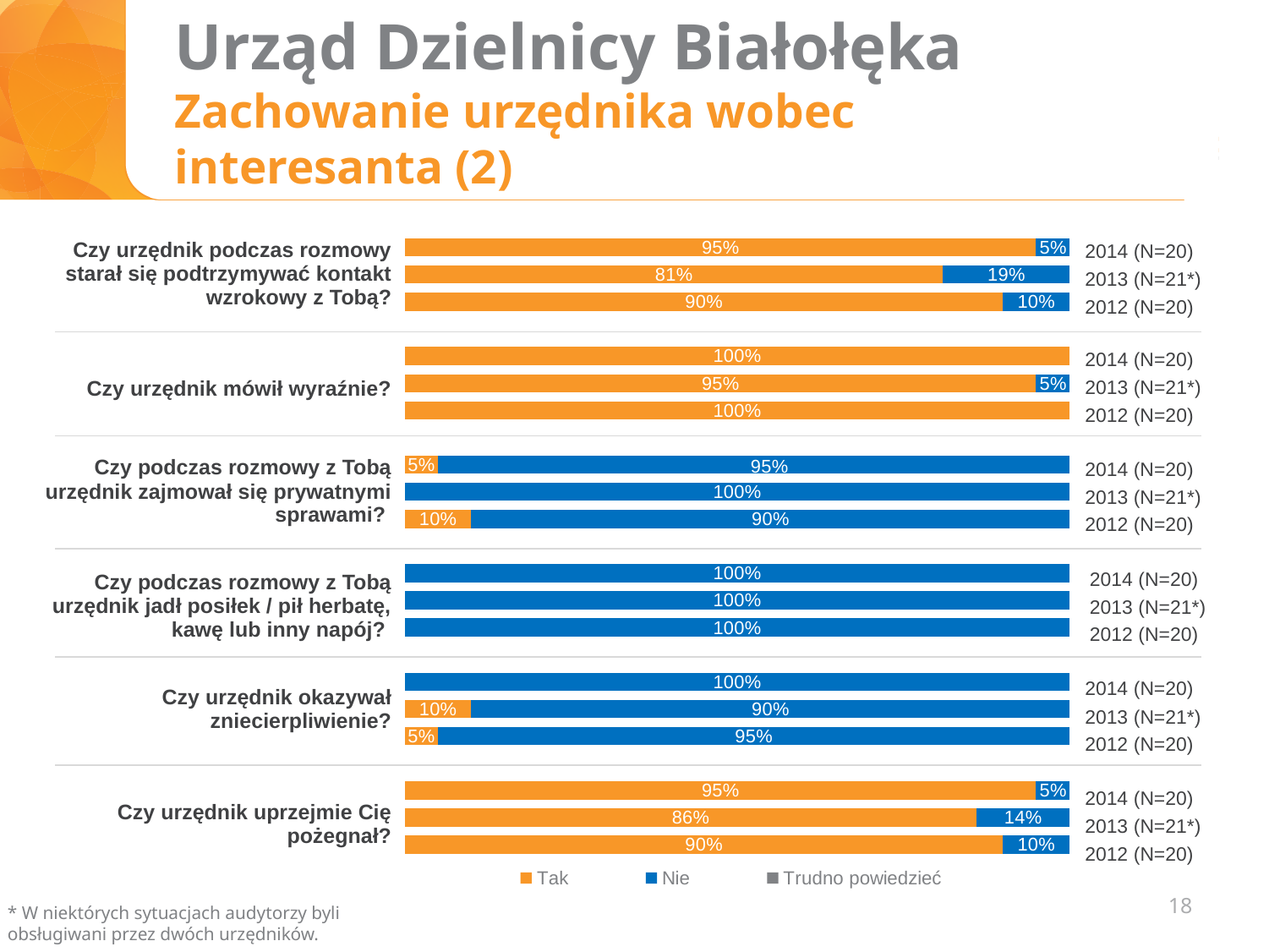
How many survey questions are shown in the chart? 6 For the question "Czy urzędnik mówił wyraźnie?", what is the "Tak" value for 2013 (N=21*)? 95% For the question "Czy urzędnik podczas rozmowy starał się podtrzymywać kontakt wzrokowy z Tobą?", what is the difference between the "Tak" value for 2014 (N=20) and for 2013 (N=21*)? 14 percentage points What are the three legend entries of the chart? Tak, Nie, Trudno powiedzieć For the question "Czy urzędnik podczas rozmowy starał się podtrzymywać kontakt wzrokowy z Tobą?", what is the "Nie" value for 2013 (N=21*)? 19% For the question "Czy urzędnik podczas rozmowy starał się podtrzymywać kontakt wzrokowy z Tobą?", what is the "Tak" value for 2013 (N=21*)? 81% What kind of chart is shown on the slide? Stacked bar chart For the question "Czy urzędnik uprzejmie Cię pożegnał?", what is the "Nie" value for 2013 (N=21*)? 14% For the question "Czy urzędnik uprzejmie Cię pożegnał?", which year has the larger "Tak" value: 2014 (N=20) or 2013 (N=21*)? 2014 (N=20) For the question "Czy urzędnik okazywał zniecierpliwienie?", what is the "Nie" value for 2013 (N=21*)? 90% How many series does the legend list? 3 For the question "Czy podczas rozmowy z Tobą urzędnik zajmował się prywatnymi sprawami?", what is the "Tak" value for 2012 (N=20)? 10%